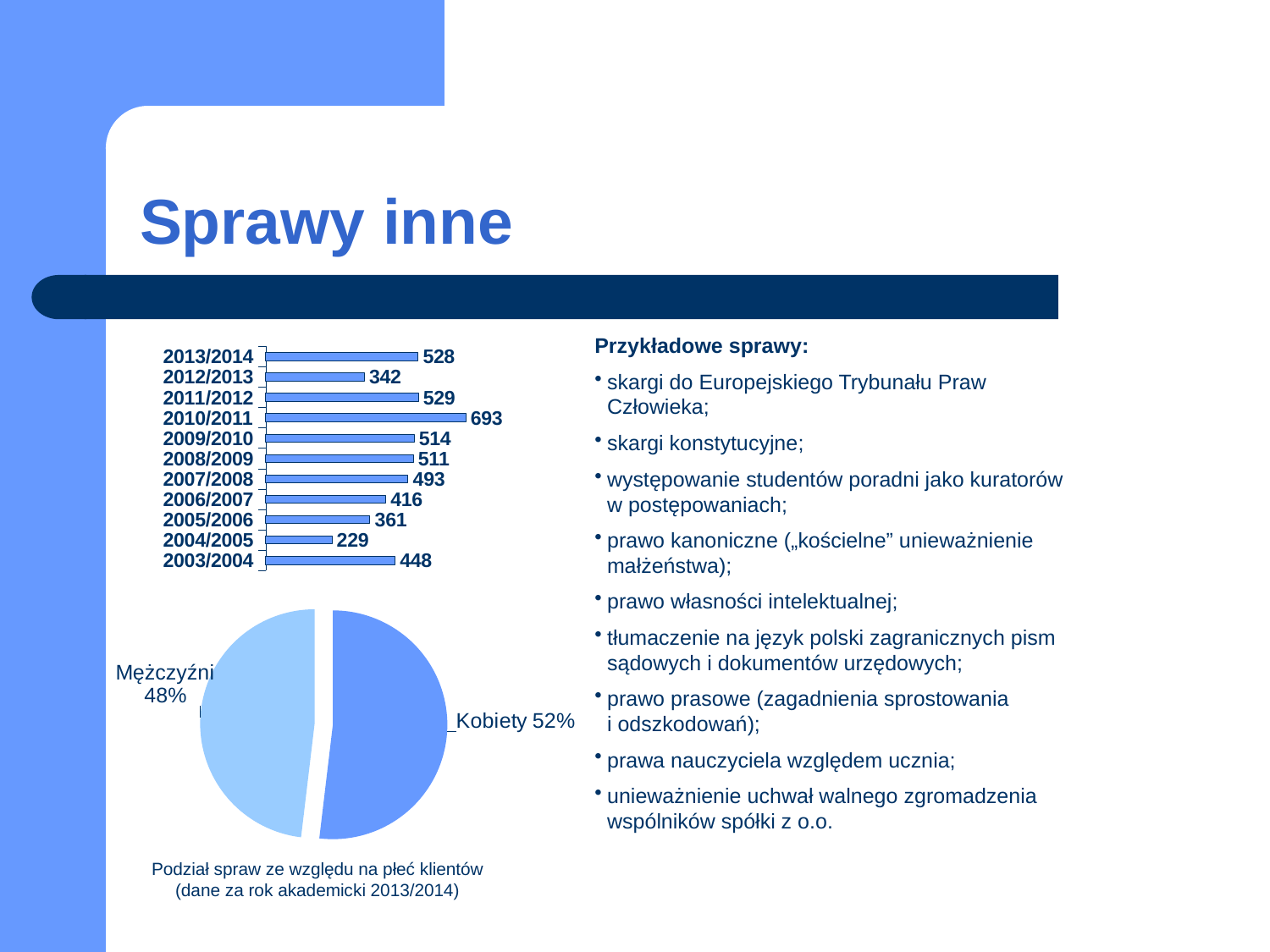
In the bar chart at the top left, what is the difference between the values for 2010/2011 and 2012/2013? 351 In the bar chart at the top left, what is the value for 2013/2014? 528 In the bar chart at the top left, what is the value for 2004/2005? 229 In the pie chart at the bottom left, what share is labelled Mężczyźni? 48% In the bar chart at the top left, which is larger, the value for 2006/2007 or the value for 2005/2006? 2006/2007 What is the caption under the pie chart at the bottom left? Podział spraw ze względu na płeć klientów (dane za rok akademicki 2013/2014) How many academic years are shown in the bar chart at the top left? 11 In the pie chart at the bottom left, what share is labelled Kobiety? 52% What kind of chart is the chart at the top left of the slide? bar chart In the bar chart at the top left, which academic year has the lowest value? 2004/2005 In the bar chart at the top left, which academic year has the highest value? 2010/2011 In the bar chart at the top left, what is the value for 2010/2011? 693